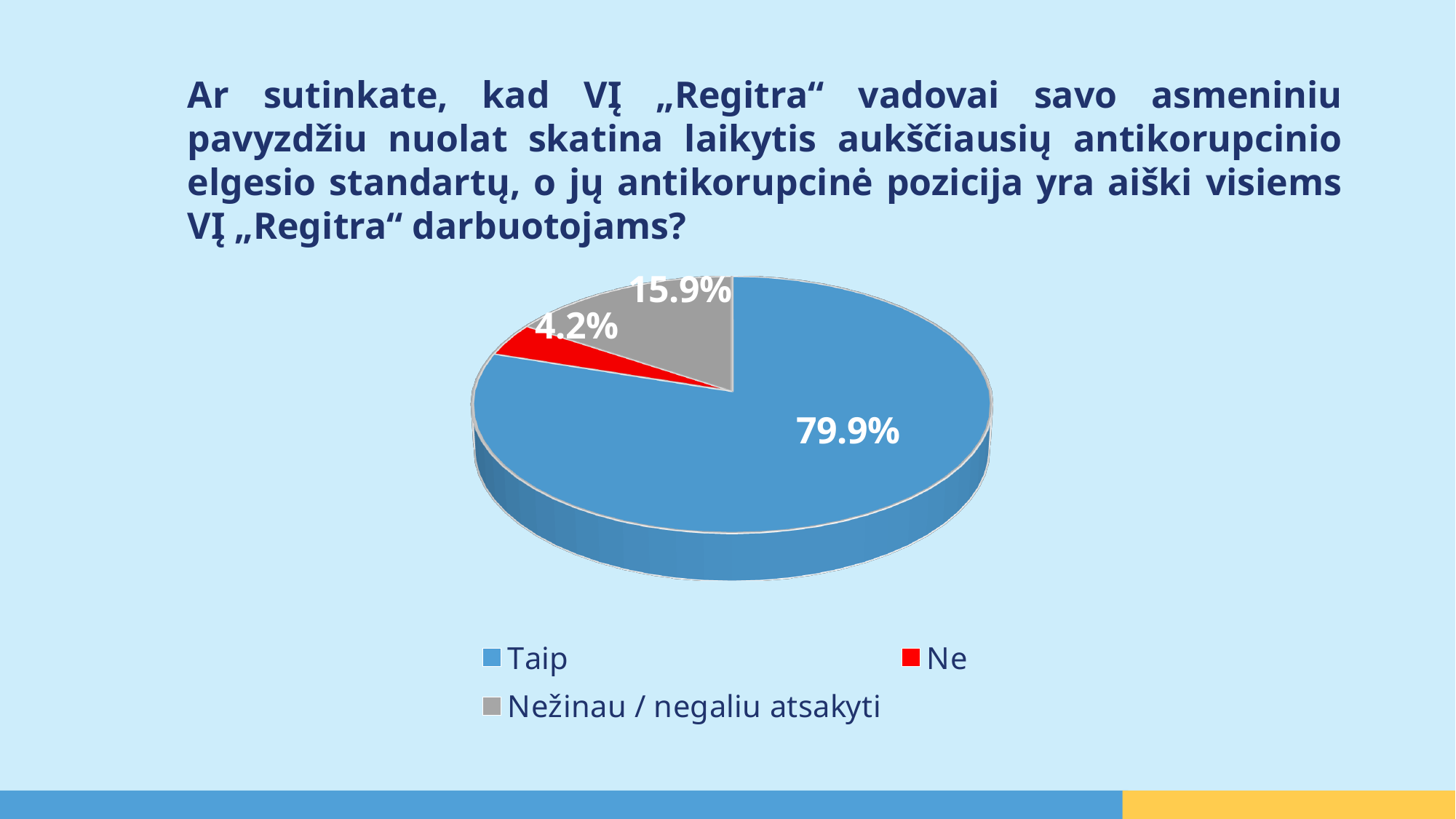
What is the difference in percentage points between "Taip" and "Nežinau / negaliu atsakyti"? 64.0% What kind of chart is shown on the slide? pie chart What is the difference in percentage points between "Nežinau / negaliu atsakyti" and "Ne"? 11.7% Which answer has the smallest share of the pie? Ne What percentage of respondents answered "Ne"? 4.2% How many entries does the legend list? 3 What percentage of respondents answered "Nežinau / negaliu atsakyti"? 15.9% What colour is the slice for "Ne"? red What percentage of respondents answered "Taip"? 79.9% Which is larger, the share for "Ne" or the share for "Nežinau / negaliu atsakyti"? Nežinau / negaliu atsakyti How many slices does the pie chart have? 3 Which answer has the largest share of the pie? Taip